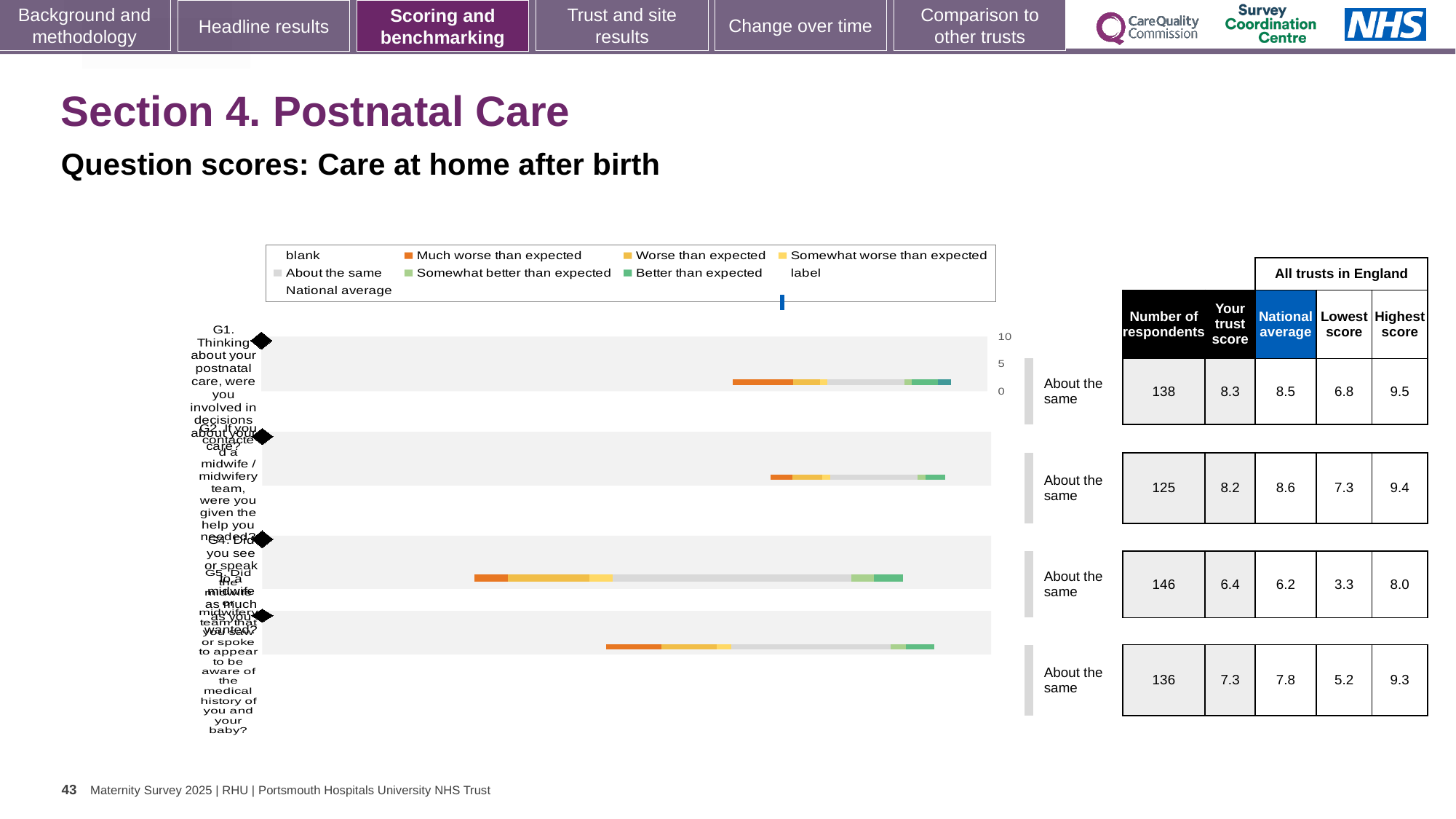
In the table, what is the highest score among all trusts in England for the fourth row? 9.3 In the table next to the chart, what is the number of respondents for the first row (G1, involved in decisions about postnatal care)? 138 For the second row, which is larger: the trust score or the national average? the national average (8.6) In the table, what is the lowest score among all trusts in England for the third row? 3.3 In the table, what is 'Your trust score' for the first row (G1)? 8.3 What colour does the legend use for 'Much worse than expected'? orange What benchmark label is shown beside each of the four bars? About the same For the first row (G1), what is the difference between the national average (8.5) and the trust score (8.3)? 0.2 How many question rows (bars) are plotted in the chart? 4 Which row in the table has the lowest 'Your trust score'? the third row (6.4) Which row in the table has the highest number of respondents? the third row (146) What kind of chart is used to show the question scores on this slide? bar chart